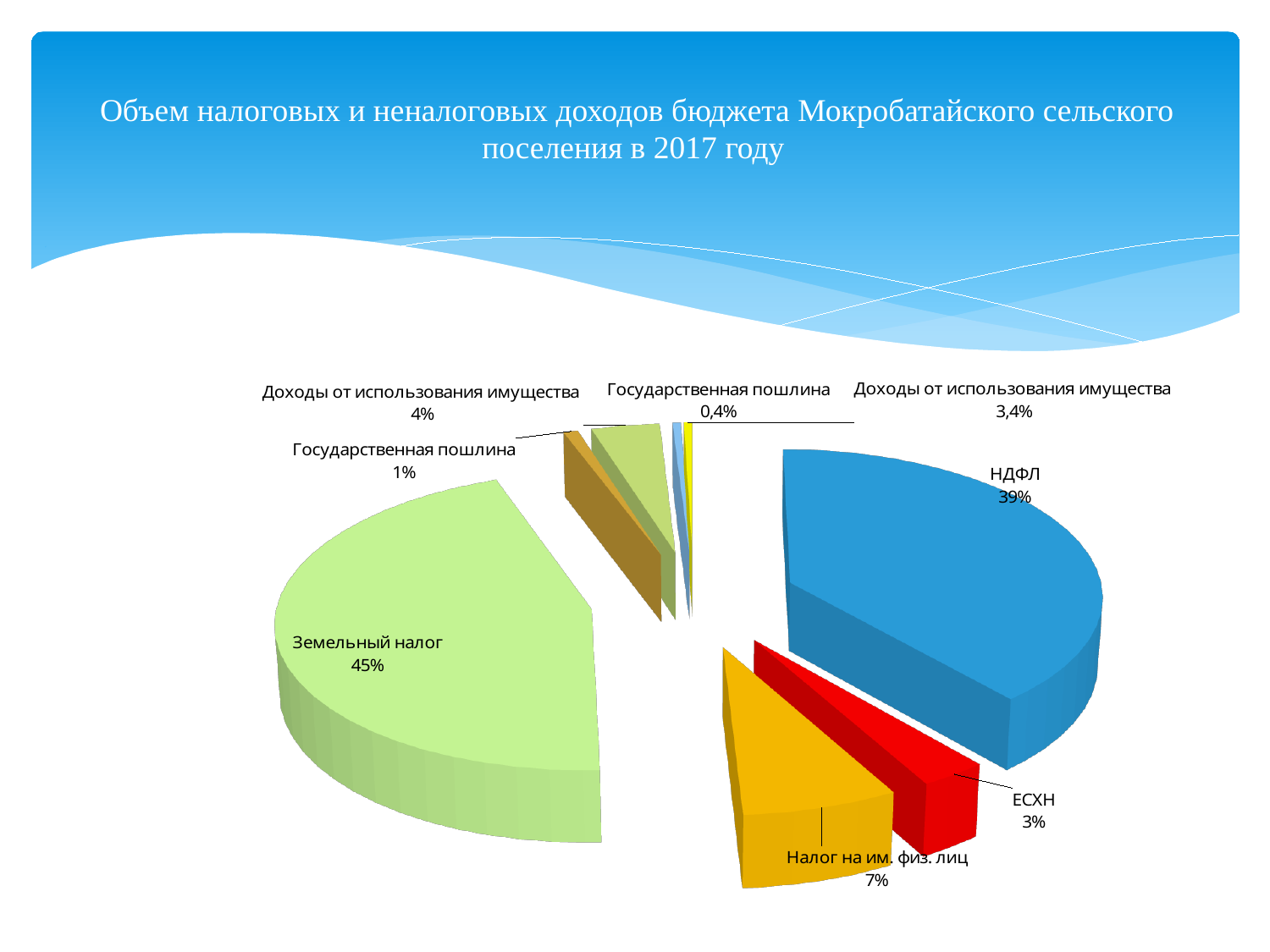
What share of the pie does Земельный налог have? 45% What share of the pie does ЕСХН have? 3% How many slices does the pie chart have? 8 What share of the pie does НДФЛ have? 39% What is the combined share of Земельный налог and НДФЛ? 84% Which category has the largest slice of the pie? Земельный налог What is the difference in percentage points between Земельный налог and НДФЛ? 6 Which is larger, the slice for Налог на им. физ. лиц or the slice for ЕСХН? Налог на им. физ. лиц What kind of chart is shown on the slide? pie chart What colour is the НДФЛ slice? blue What share of the pie does Налог на им. физ. лиц have? 7%